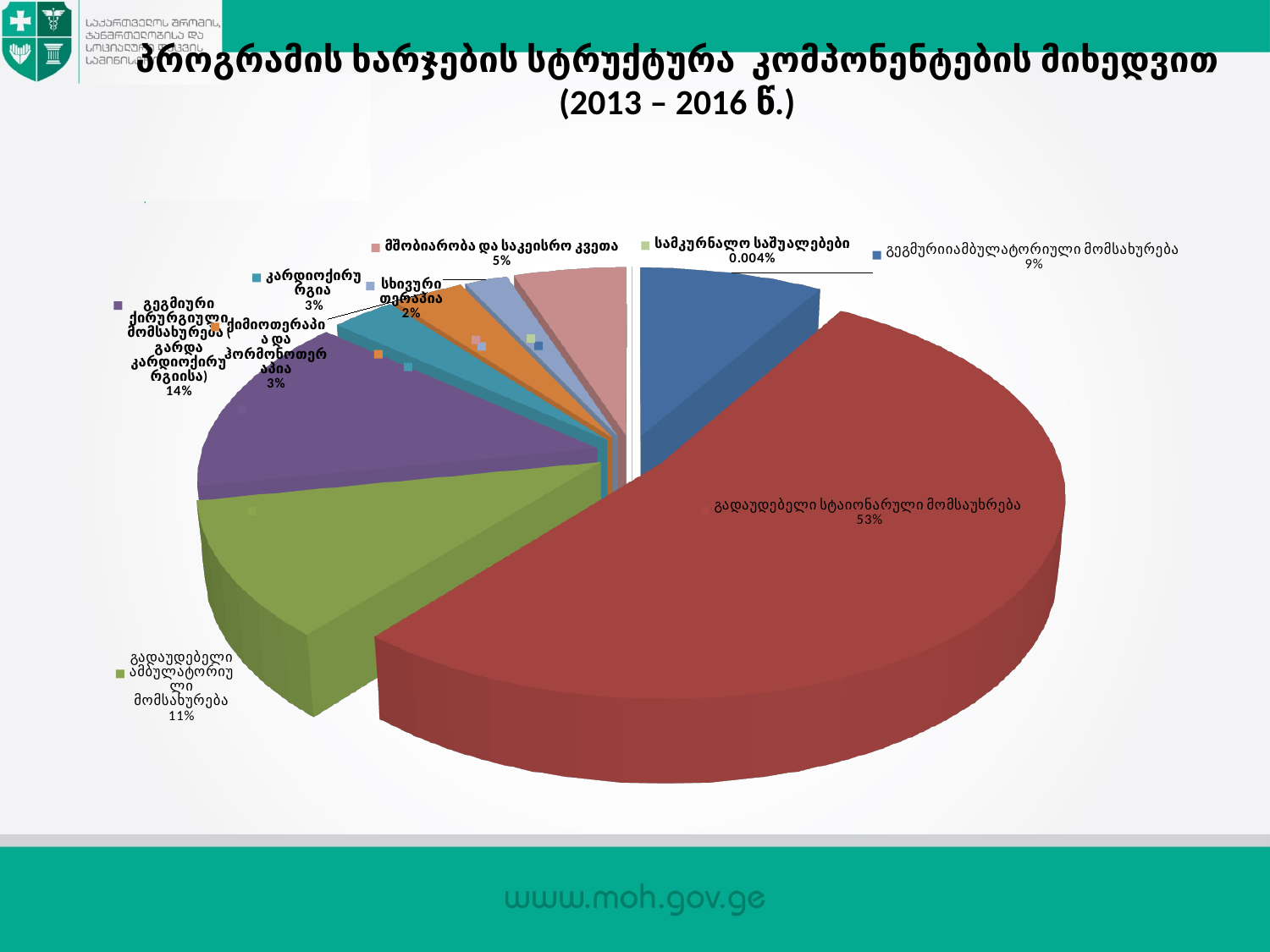
What years does the chart title say the data covers? 2013 – 2016 Which category has the largest share of the pie? გადაუდებელი სტაციონარული მომსახურება What share of the pie does სამკურნალო საშუალებები have? 0.004% Which category has the smallest share of the pie? სამკურნალო საშუალებები Which is larger: the share for გეგმიური ქირურგიული მომსახურება (გარდა კარდიოქირურგიისა) or the share for გადაუდებელი ამბულატორიული მომსახურება? გეგმიური ქირურგიული მომსახურება (გარდა კარდიოქირურგიისა) What share of the pie does გეგმიური ქირურგიული მომსახურება (გარდა კარდიოქირურგიისა) have? 14% What share of the pie does გადაუდებელი ამბულატორიული მომსახურება have? 11% How many slices does the pie chart have? 9 What kind of chart is shown on the slide? pie chart What is the difference in percentage points between გადაუდებელი სტაციონარული მომსახურება and გეგმური ამბულატორიული მომსახურება? 44